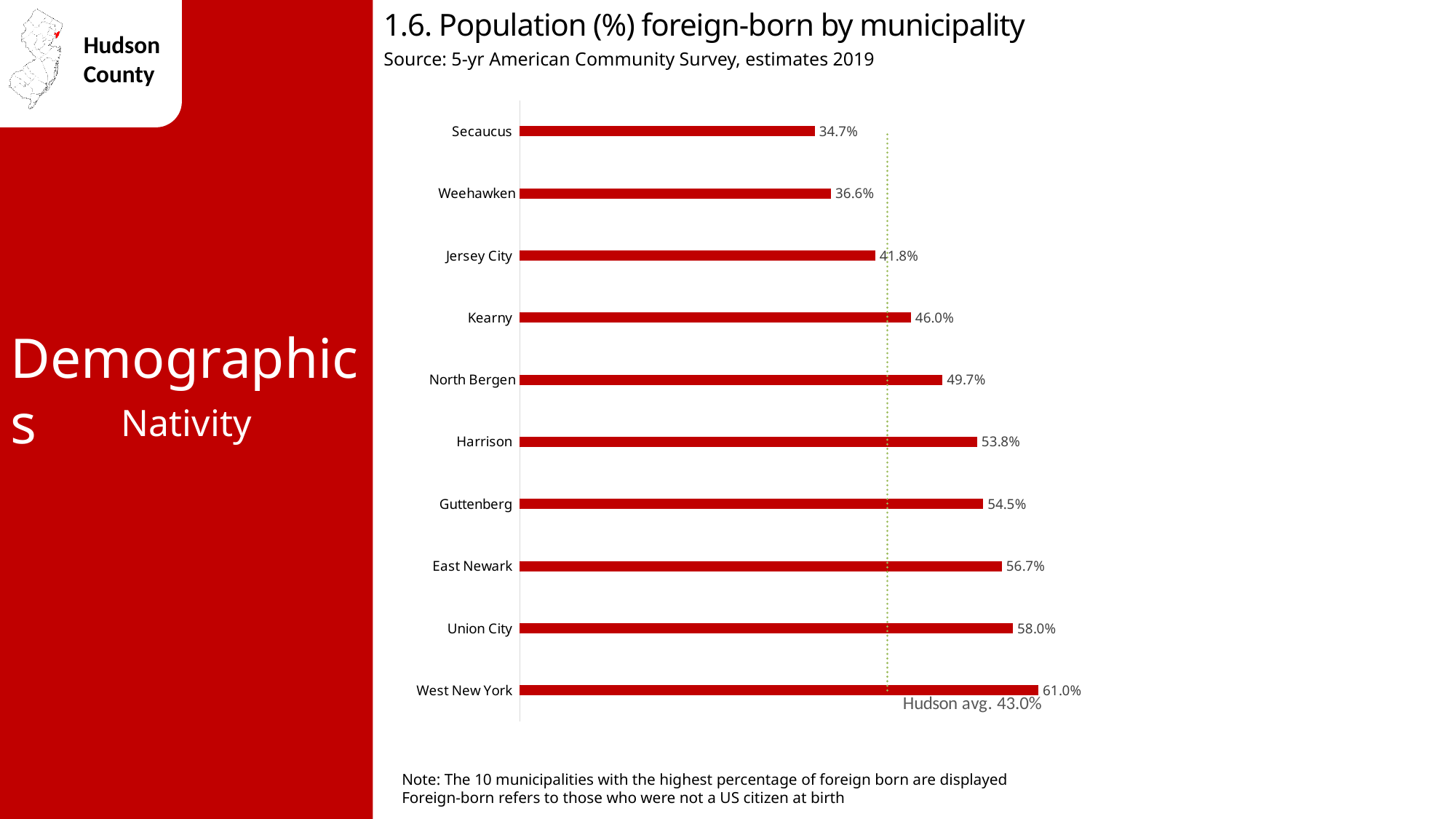
What is the foreign-born population percentage for Union City? 58.0% What is the foreign-born population percentage for Secaucus? 34.7% Which has a higher foreign-born percentage, North Bergen or Weehawken? North Bergen What is the difference in foreign-born percentage between Harrison and Kearny? 7.8 percentage points What is the difference in foreign-born percentage between West New York and Secaucus? 26.3 percentage points Which municipality has the lowest percentage of foreign-born population? Secaucus What is the foreign-born population percentage for Jersey City? 41.8% What is the source of the data shown in the chart? 5-yr American Community Survey, estimates 2019 How many municipalities are shown in the chart? 10 What is the Hudson County average foreign-born percentage shown by the dotted line? 43.0% What type of chart is used on this slide? Bar chart Which municipality has the highest percentage of foreign-born population? West New York